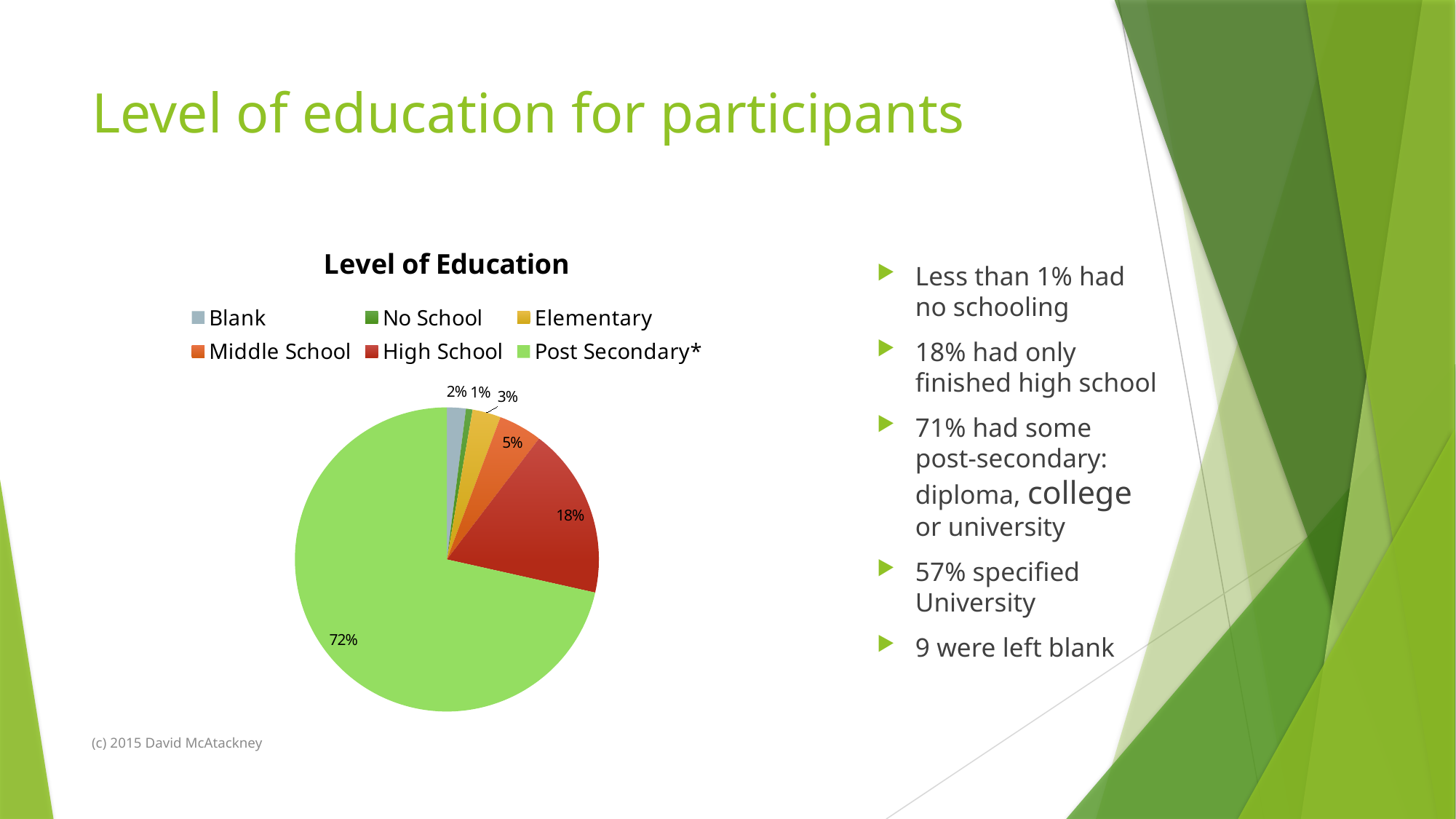
What percentage of the pie is High School? 18% What is the difference in percentage points between Post Secondary* and High School? 54 What kind of chart is shown on the slide? pie chart What percentage of the pie is Blank? 2% Which category has the smallest slice of the pie? No School Which slice is larger, Middle School or Elementary? Middle School What percentage of the pie is Middle School? 5% What percentage of the pie is Elementary? 3% What is the title of the chart? Level of Education How many categories does the legend of the pie chart list? 6 Which category has the largest slice of the pie? Post Secondary* What percentage of the pie is Post Secondary*? 72%